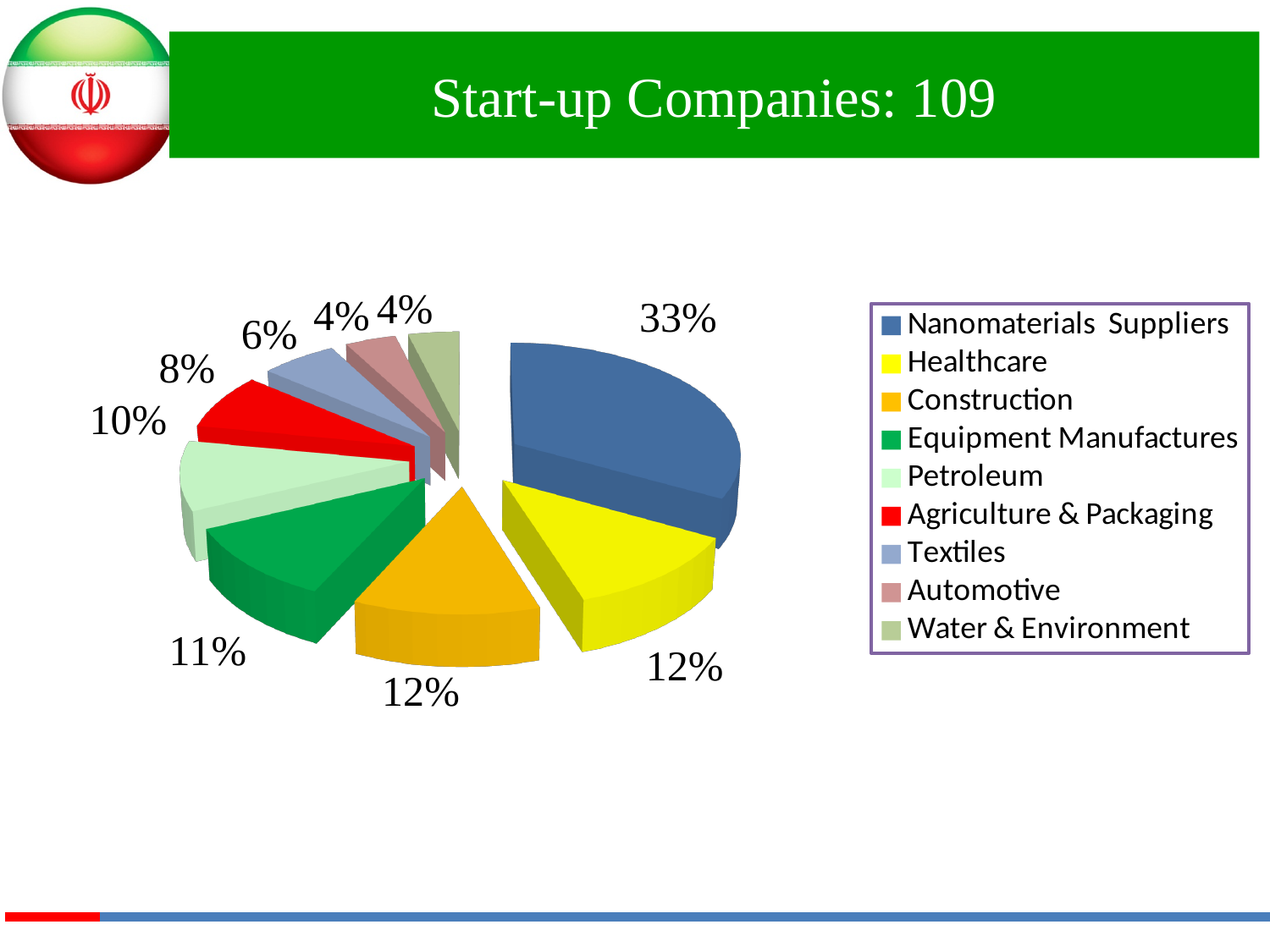
Which is larger, the share for Petroleum or the share for Textiles? Petroleum What colour is the Healthcare slice in the pie chart? yellow What is the value shown for Petroleum? 10% What is the difference between the shares of Nanomaterials Suppliers and Healthcare? 21% How many categories does the legend list? 9 What is the value shown for Textiles? 6% What share of the pie does Nanomaterials Suppliers hold? 33% What is the title of the slide containing the chart? Start-up Companies: 109 What is the value shown for Equipment Manufactures? 11% What is the value shown for Agriculture & Packaging? 8% What type of chart is shown on the slide? pie chart Which category has the largest share of the pie? Nanomaterials Suppliers